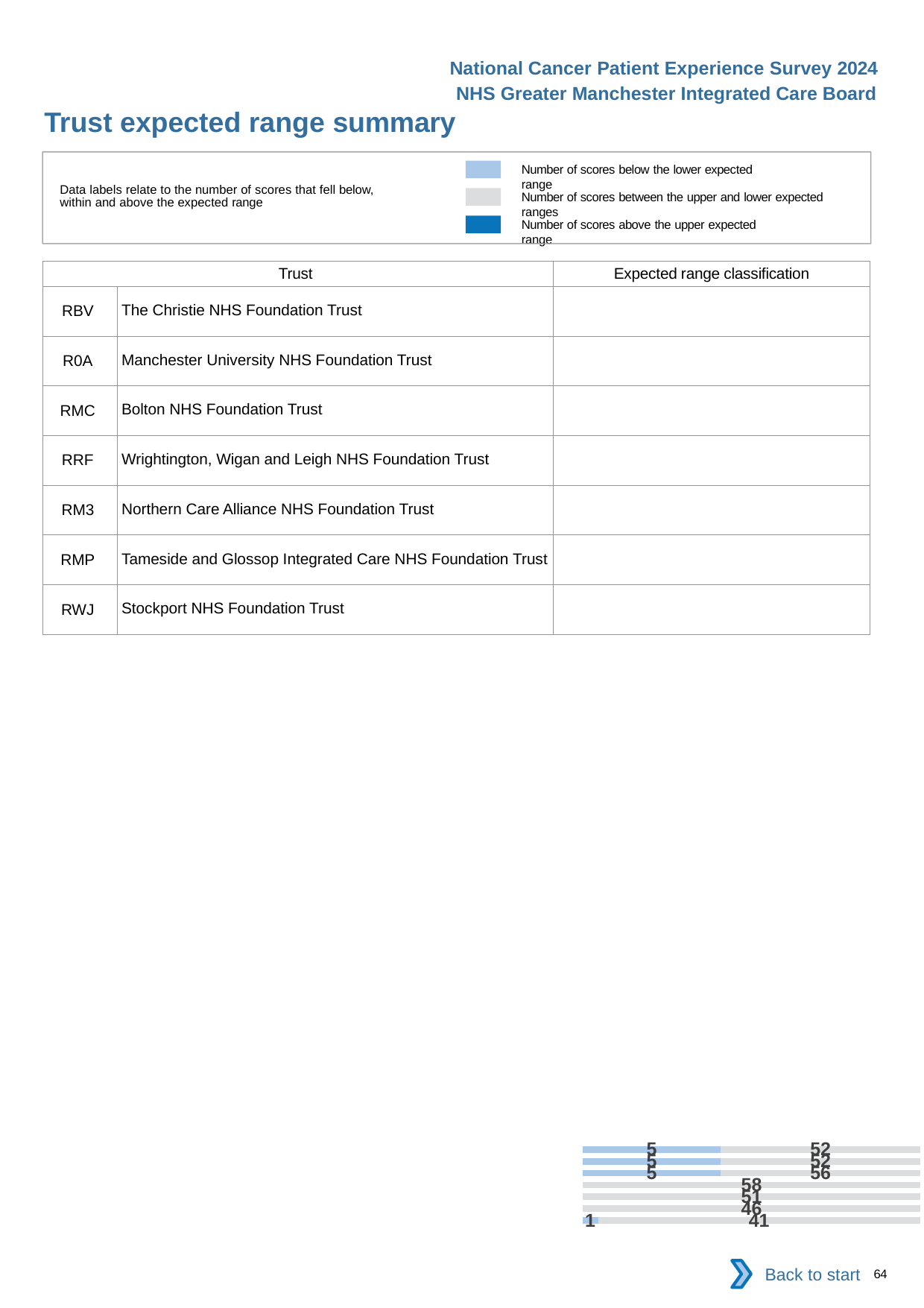
In the chart at the bottom of the slide, what is the total of the top bar? 57 How many bars does the chart at the bottom of the slide contain? 7 In the chart at the bottom of the slide, what is the grey (within expected range) value on the bottom bar? 41 What kind of chart is shown at the bottom of the slide? Stacked bar chart In the chart at the bottom of the slide, what is the grey value on the fourth bar from the top? 58 How many categories does the legend in the box at the top of the slide list? 3 In the chart at the bottom of the slide, which is larger: the grey value on the top bar or the grey value on the bottom bar? Top bar According to the legend, what does the dark blue colour represent? Number of scores above the upper expected range In the chart at the bottom of the slide, what is the grey value on the top bar? 52 In the chart at the bottom of the slide, what is the light blue value on the top bar? 5 In the chart at the bottom of the slide, what is the light blue (below lower expected range) value on the bottom bar? 1